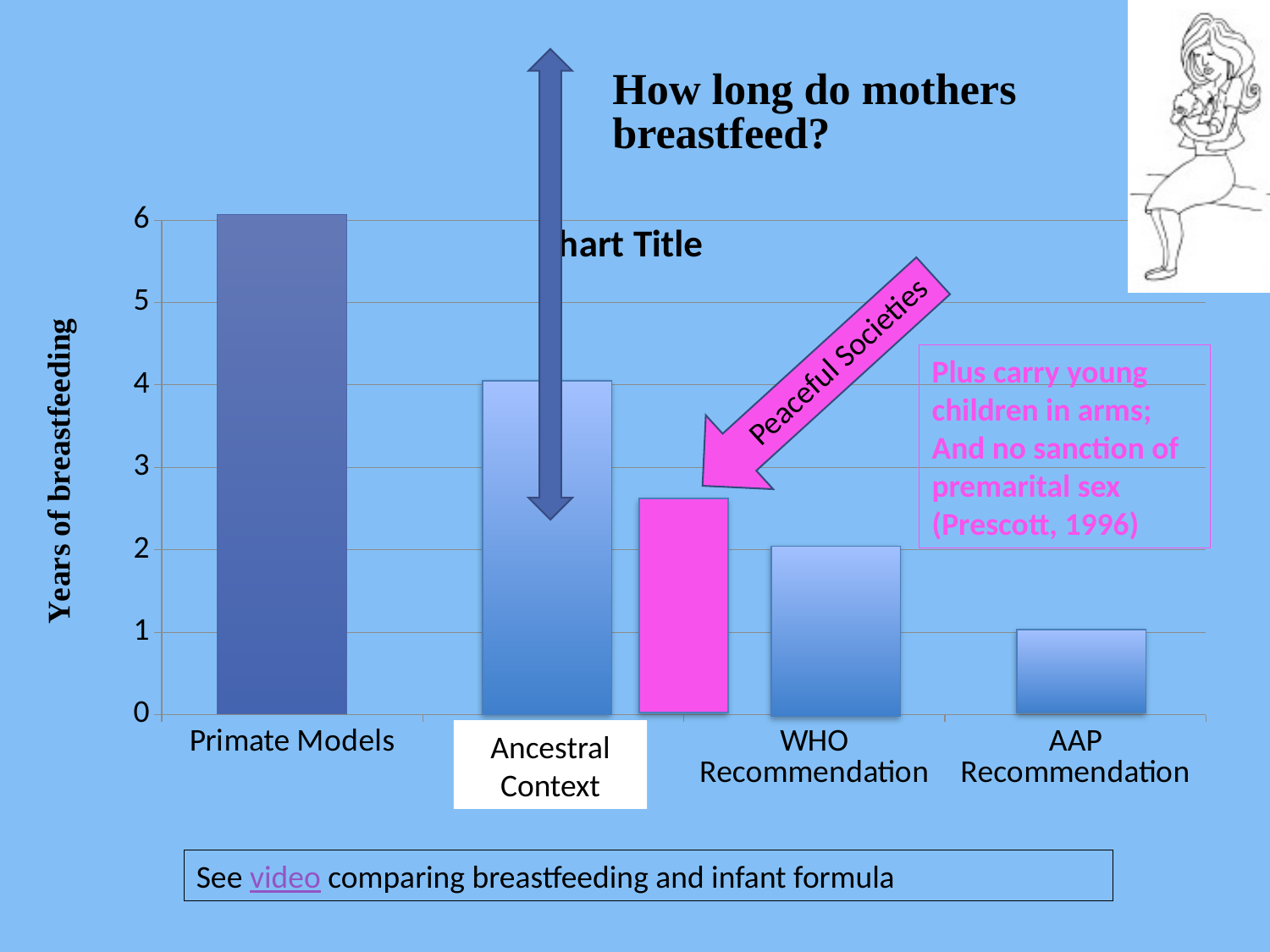
Which category has the highest value in the chart? Primate Models What kind of chart is shown on the slide? bar chart Is the value for AAP Recommendation greater or less than 2? less Which is larger, the value for Ancestral Context or the value for WHO Recommendation? Ancestral Context Is the value for Peaceful Societies greater or less than 3? less How many bars are plotted in the chart? 5 Which is larger, the value for Peaceful Societies or the value for AAP Recommendation? Peaceful Societies Is the value for Primate Models greater or less than 5? greater Which category has the lowest value in the chart? AAP Recommendation What is the label on the vertical axis of the chart? Years of breastfeeding Do the bar values rise or fall moving from left to right across the chart? fall